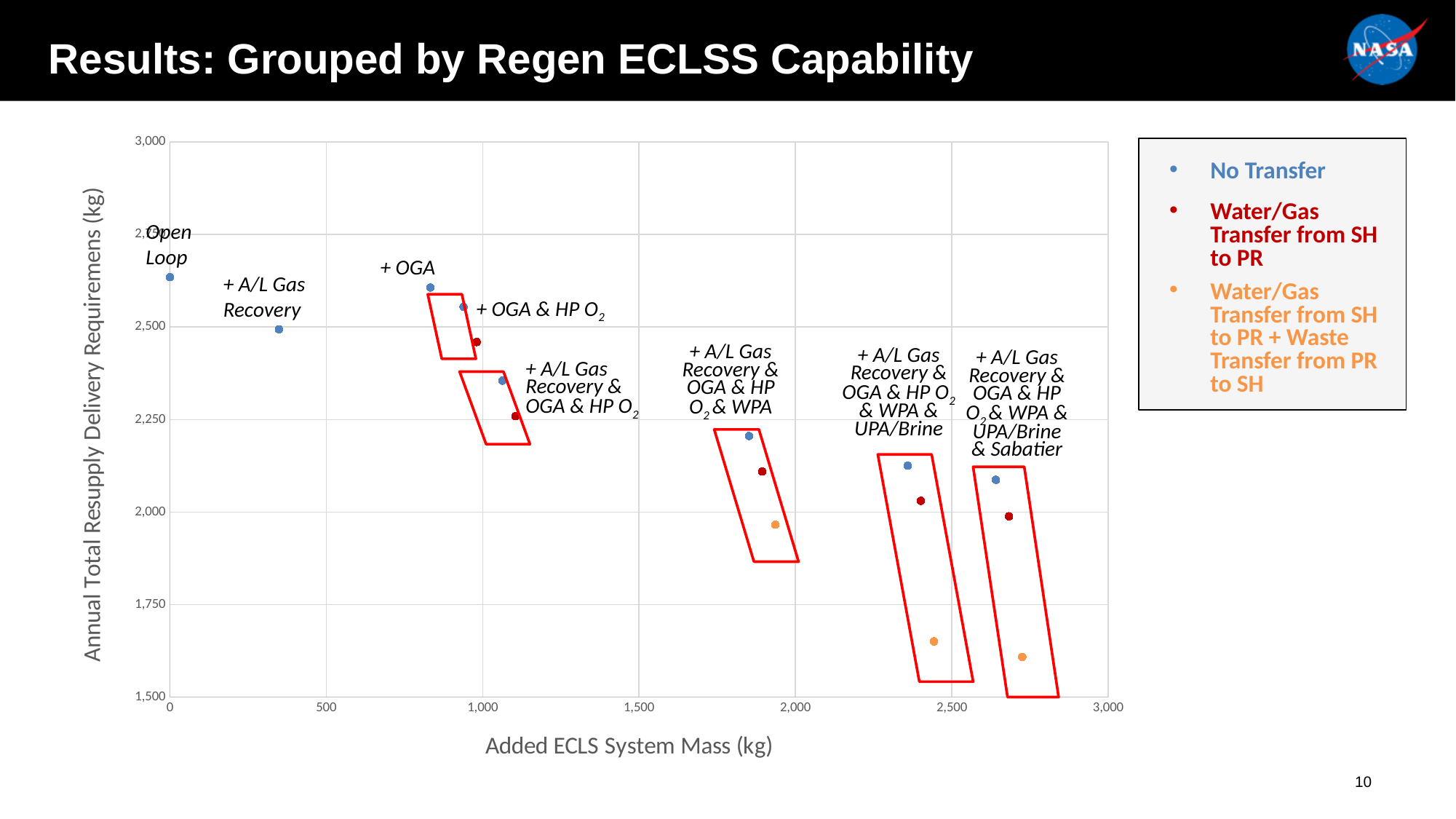
How many series does the legend list? 3 Is the Added ECLS System Mass for the + A/L Gas Recovery point greater or less than 500? less Is the orange (Water/Gas Transfer + Waste Transfer) point in the Sabatier group greater or less than 1,750 on the y axis? less Which has the higher Annual Total Resupply Delivery Requirement: the Open Loop point or the + A/L Gas Recovery point? Open Loop How many red outlined groups are drawn on the chart? 5 What is the title of the x axis? Added ECLS System Mass (kg) Is the Annual Total Resupply Delivery Requirement for the Open Loop point greater or less than 2,500? greater What kind of chart is shown on the slide? Scatter chart How many orange (Water/Gas Transfer from SH to PR + Waste Transfer from PR to SH) points are plotted? 3 What is the title of the y axis? Annual Total Resupply Delivery Requiremens (kg) Which has the higher Annual Total Resupply Delivery Requirement: the No Transfer point for + OGA or the No Transfer point in the Sabatier group? + OGA